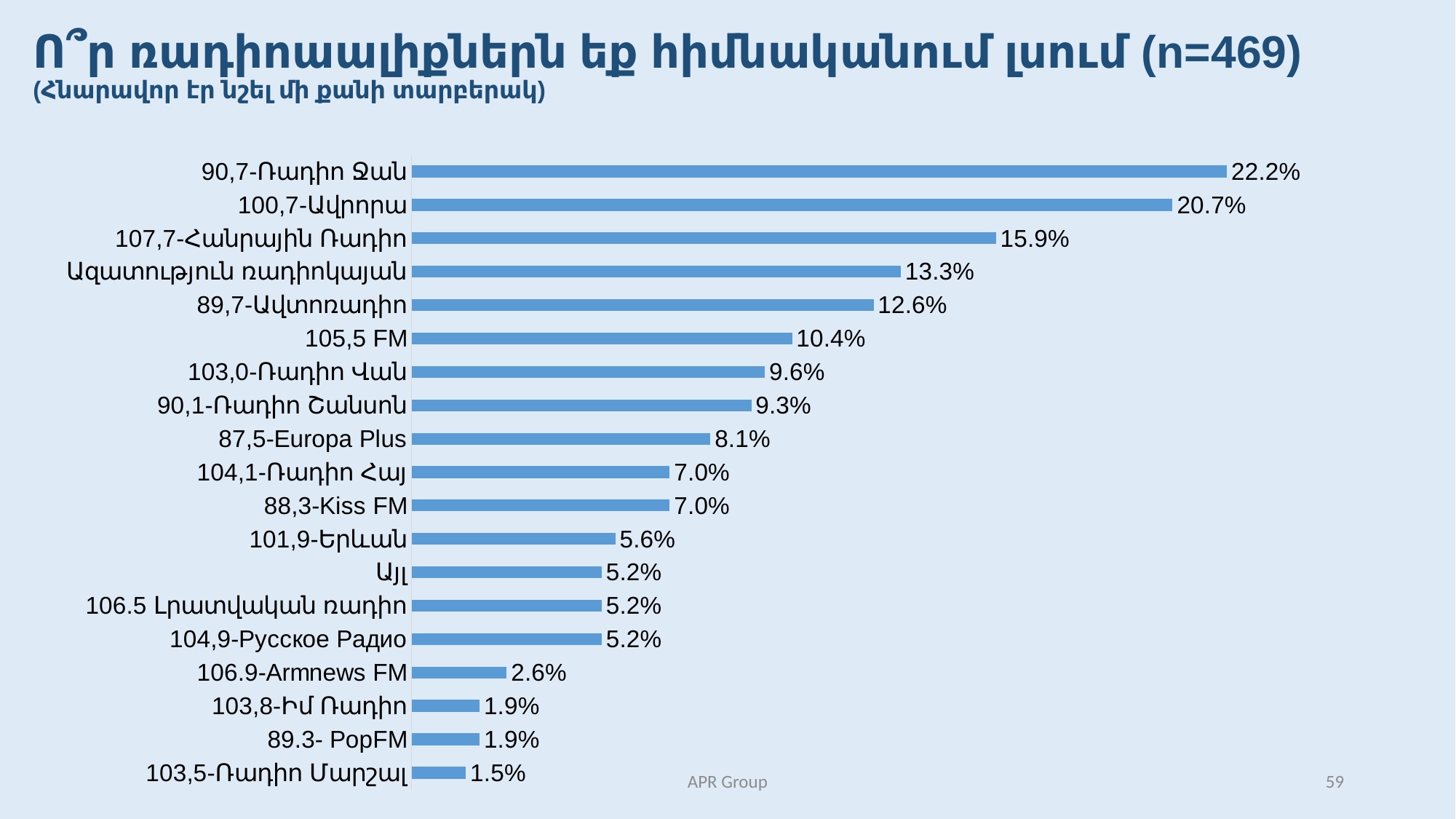
Which radio station has the highest value? 90,7-Ռադիո Ջան Which radio station has the lowest value? 103,5-Ռադիո Մարշալ What is the value for 90,7-Ռադիո Ջան? 22.2% Which is larger, the value for 103,0-Ռադիո Վան or the value for 101,9-Երևան? 103,0-Ռադիո Վան What is the value for 106.9-Armnews FM? 2.6% What is the value for 87,5-Europa Plus? 8.1% How many radio station categories are shown in the chart? 19 What kind of chart is shown on the slide? Bar chart What is the difference between the values for 107,7-Հանրային Ռադիո and 89,7-Ավտոռադիո? 3.3% What is the sample size (n) stated in the chart title? 469 What is the difference between the values for 90,7-Ռադիո Ջան and 100,7-Ավրորա? 1.5% What is the value for 105,5 FM? 10.4%